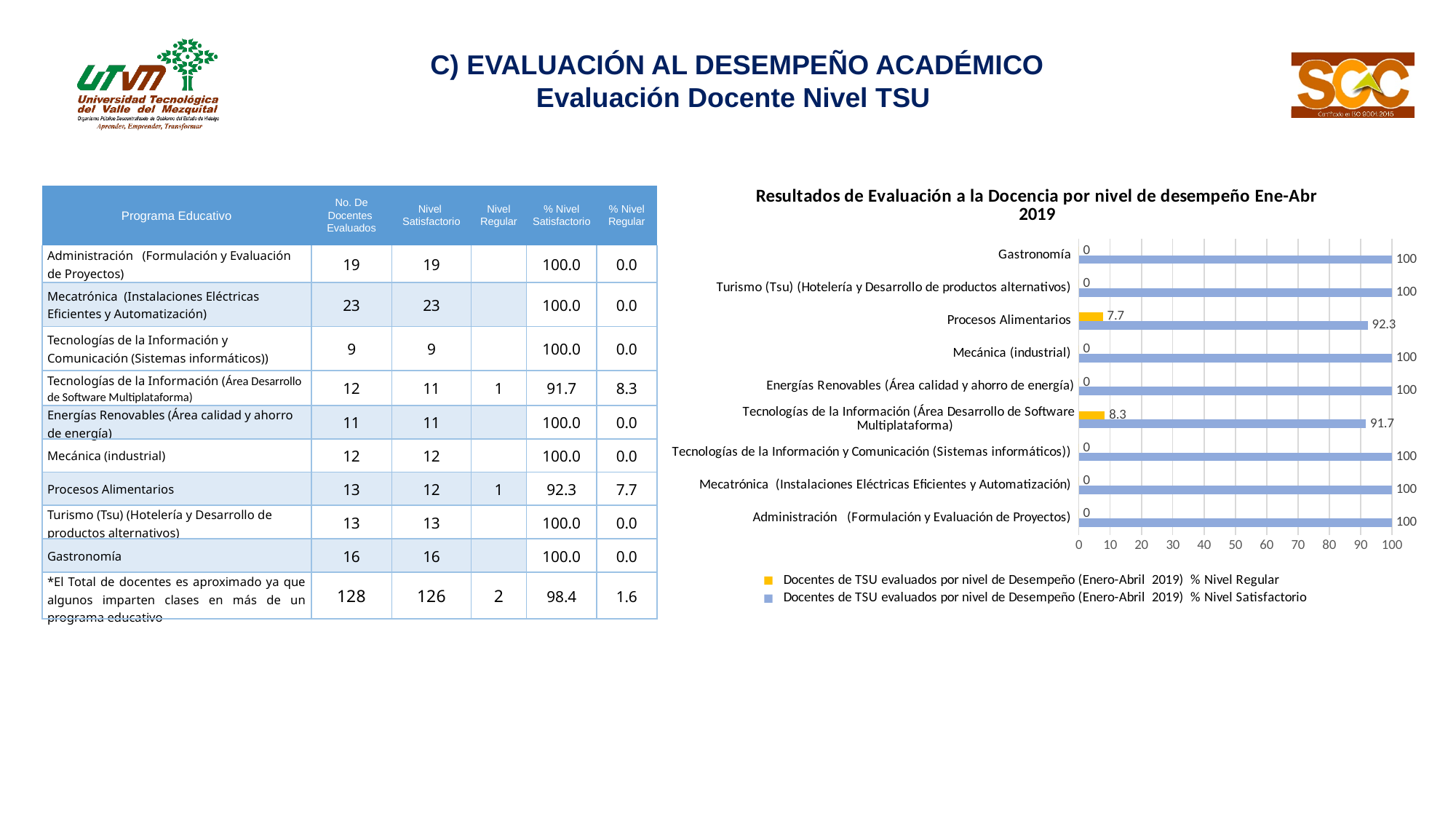
What kind of chart is shown on the slide? Bar chart What colour represents the % Nivel Regular series in the chart? Yellow How many programs (categories) are shown in the chart? 9 Which is larger: the % Nivel Satisfactorio value for Mecánica (industrial) or for Procesos Alimentarios? Mecánica (industrial) What is the difference between the % Nivel Satisfactorio and % Nivel Regular values for Procesos Alimentarios? 84.6 Which program has the lowest % Nivel Satisfactorio value? Tecnologías de la Información (Área Desarrollo de Software Multiplataforma) What is the % Nivel Regular value for Tecnologías de la Información (Área Desarrollo de Software Multiplataforma)? 8.3 What is the % Nivel Satisfactorio value for Gastronomía? 100 How many series does the chart legend list? 2 Which program has the highest % Nivel Regular value? Tecnologías de la Información (Área Desarrollo de Software Multiplataforma) Is the % Nivel Satisfactorio value for Tecnologías de la Información (Área Desarrollo de Software Multiplataforma) greater or less than 80? greater What is the % Nivel Satisfactorio value for Procesos Alimentarios? 92.3